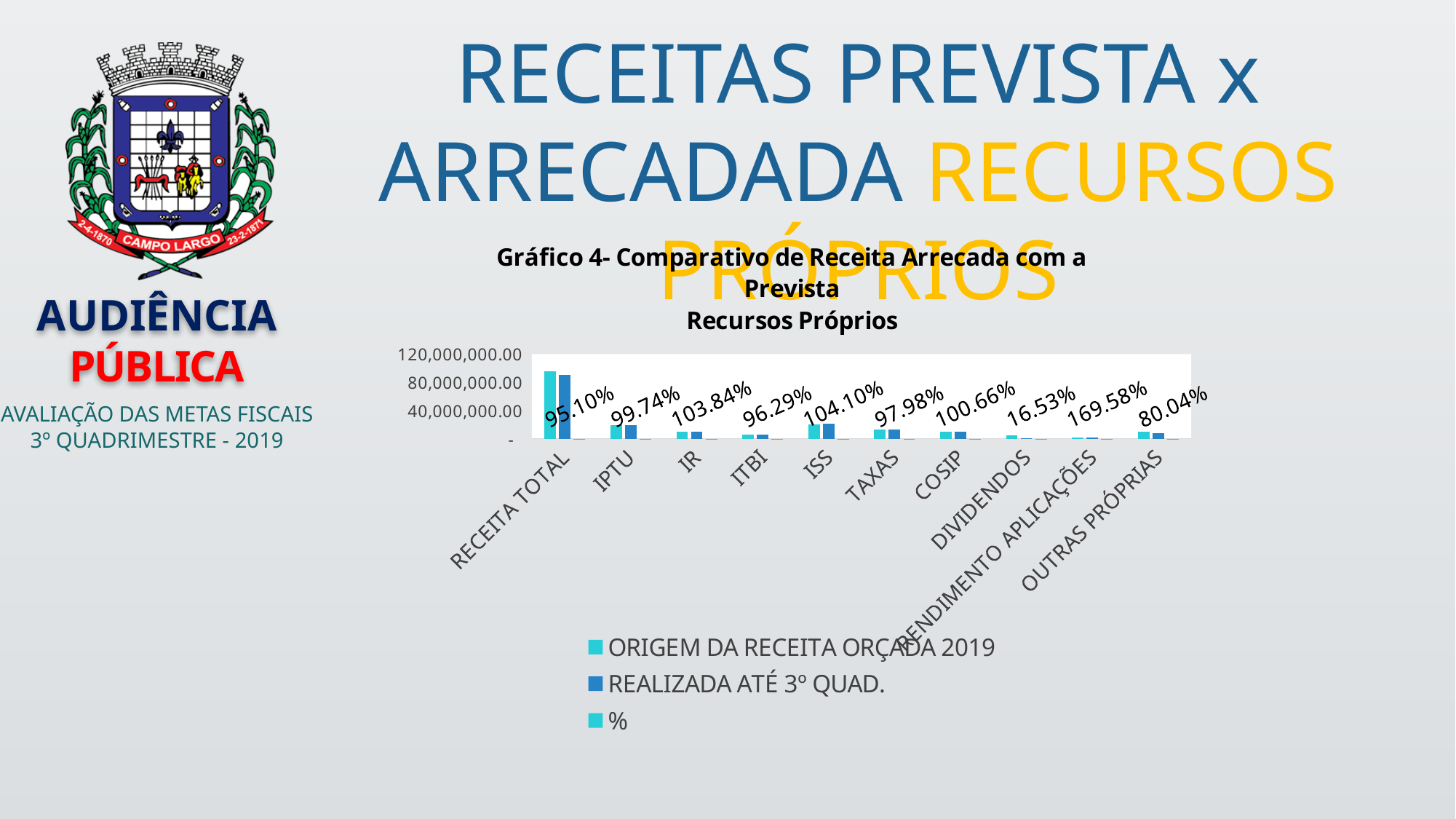
What is the percentage label shown for DIVIDENDOS? 16.53% Which category has the highest percentage label? RENDIMENTO APLICAÇÕES Which has a higher percentage label, ISS or IPTU? ISS How many series does the chart legend list? 3 Which category has the lowest percentage label? DIVIDENDOS What is the percentage label shown for RECEITA TOTAL? 95.10% What is the difference between the percentage labels for ISS and RECEITA TOTAL? 9.00% Is the ORIGEM DA RECEITA ORÇADA 2019 value for RECEITA TOTAL greater or less than 80,000,000.00? greater What is the percentage label shown for IPTU? 99.74% What kind of chart is shown on the slide? bar chart How many categories are shown on the x axis of the chart? 10 What is the second series listed in the chart legend? REALIZADA ATÉ 3º QUAD.